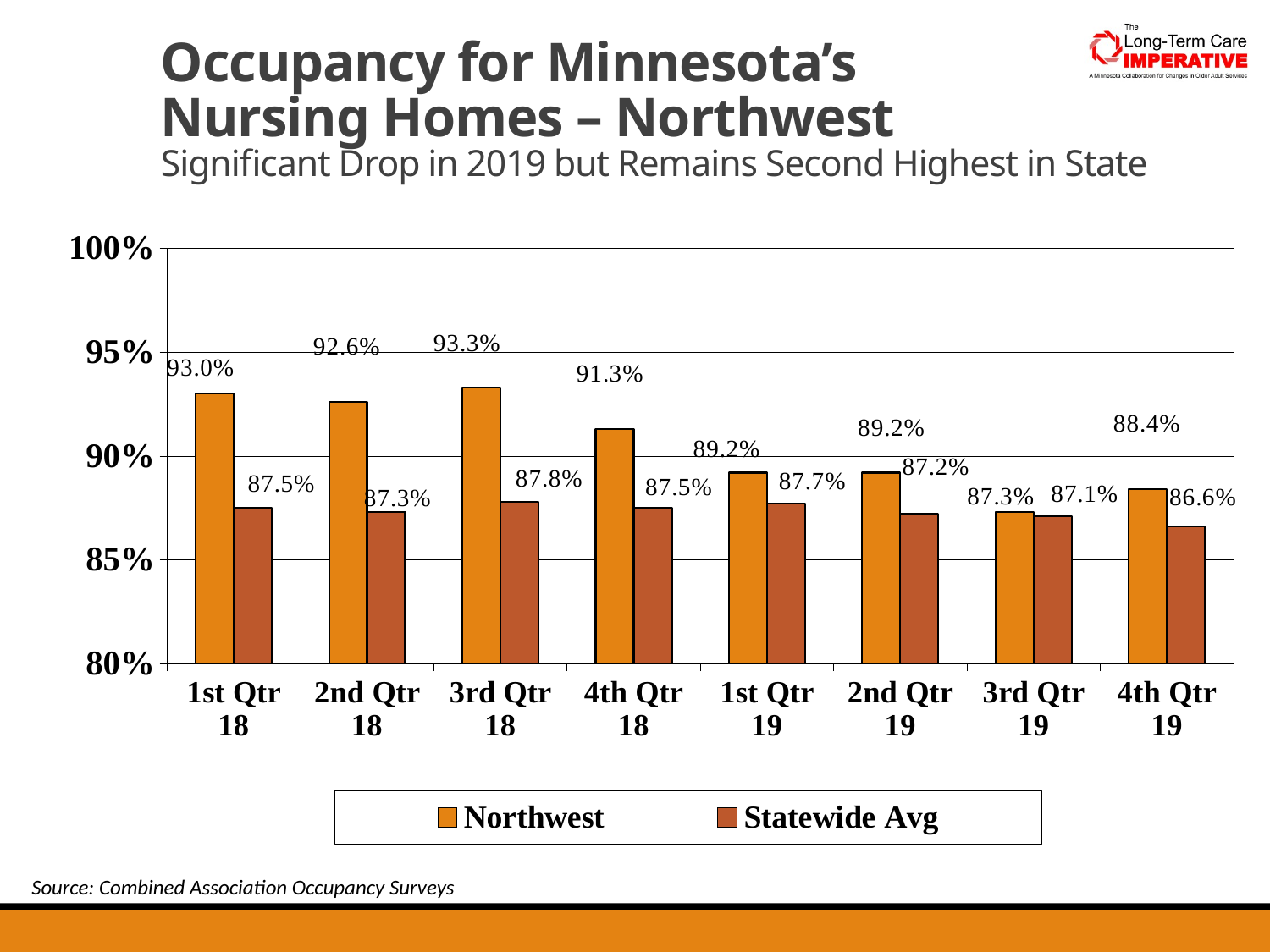
In which quarter is the Statewide Avg lowest? 4th Qtr 19 What is the Statewide Avg value for 4th Qtr 19? 86.6% How many series does the legend list? 2 In which quarter is the Northwest occupancy lowest? 3rd Qtr 19 What is the Northwest value for 4th Qtr 18? 91.3% How many quarters are shown on the x axis? 8 What is the Northwest occupancy value for 3rd Qtr 18? 93.3% Does the Northwest occupancy generally rise or fall from 1st Qtr 18 to 4th Qtr 19? Fall Which is larger in 4th Qtr 19, the Northwest value or the Statewide Avg value? Northwest What is the difference between the Northwest value and the Statewide Avg value in 1st Qtr 18? 5.5 percentage points What kind of chart is shown on the slide? Bar chart In which quarter is the Northwest occupancy highest? 3rd Qtr 18